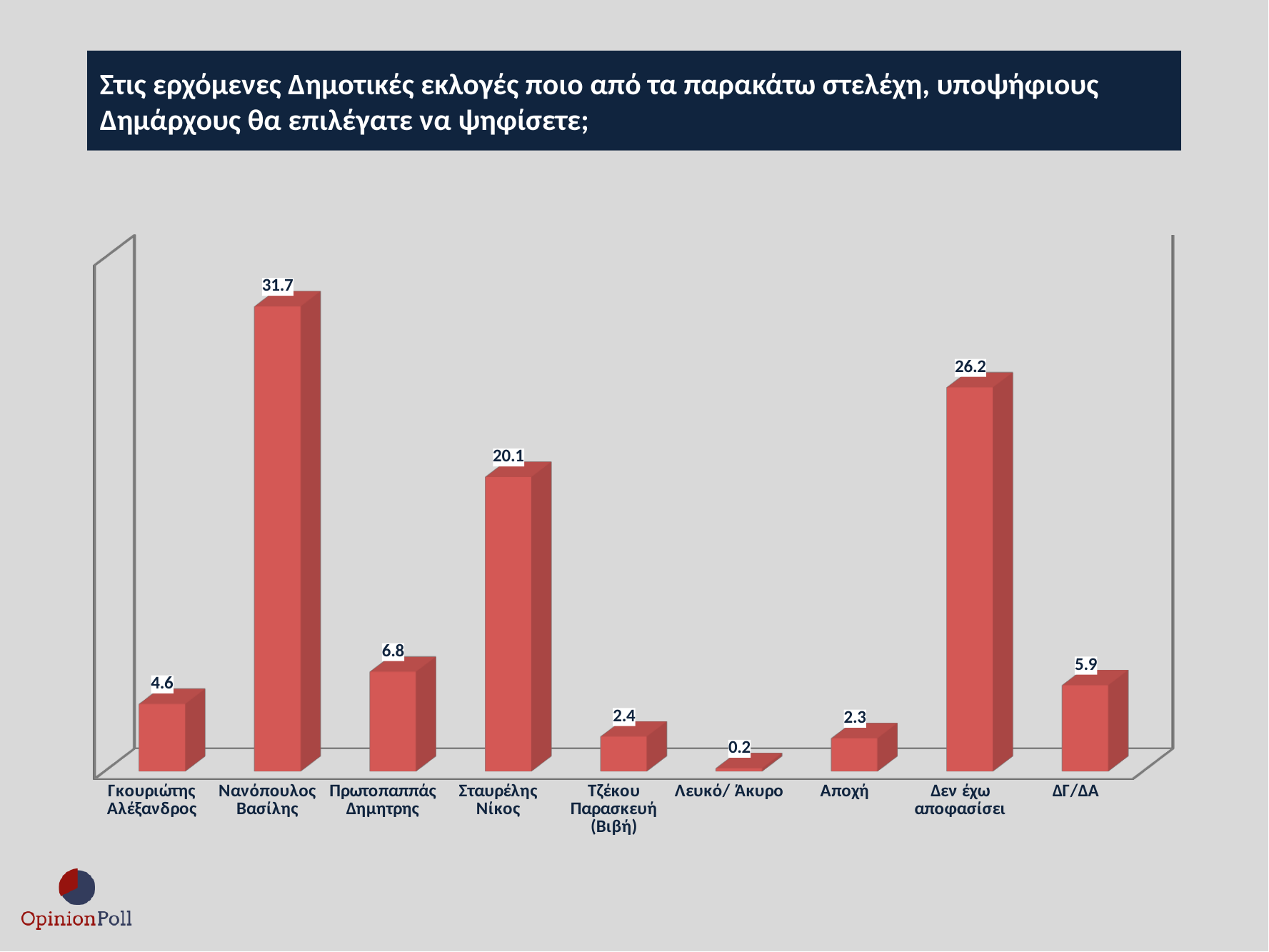
What is the difference between the values for Νανόπουλος Βασίλης and Δεν έχω αποφασίσει? 5.5 What is the difference between the values for Πρωτοπαππάς Δημήτρης and Γκουριώτης Αλέξανδρος? 2.2 What is the value for Νανόπουλος Βασίλης? 31.7 What kind of chart is shown on the slide? bar chart Which category has the lowest value? Λευκό/ Άκυρο What colour are the bars in the chart? red What is the value for Τζέκου Παρασκευή (Βιβή)? 2.4 How many categories are shown on the x axis? 9 Which is larger, the value for ΔΓ/ΔΑ or the value for Γκουριώτης Αλέξανδρος? ΔΓ/ΔΑ What is the value for Δεν έχω αποφασίσει? 26.2 Which category has the highest value? Νανόπουλος Βασίλης What is the value for Σταυρέλης Νίκος? 20.1